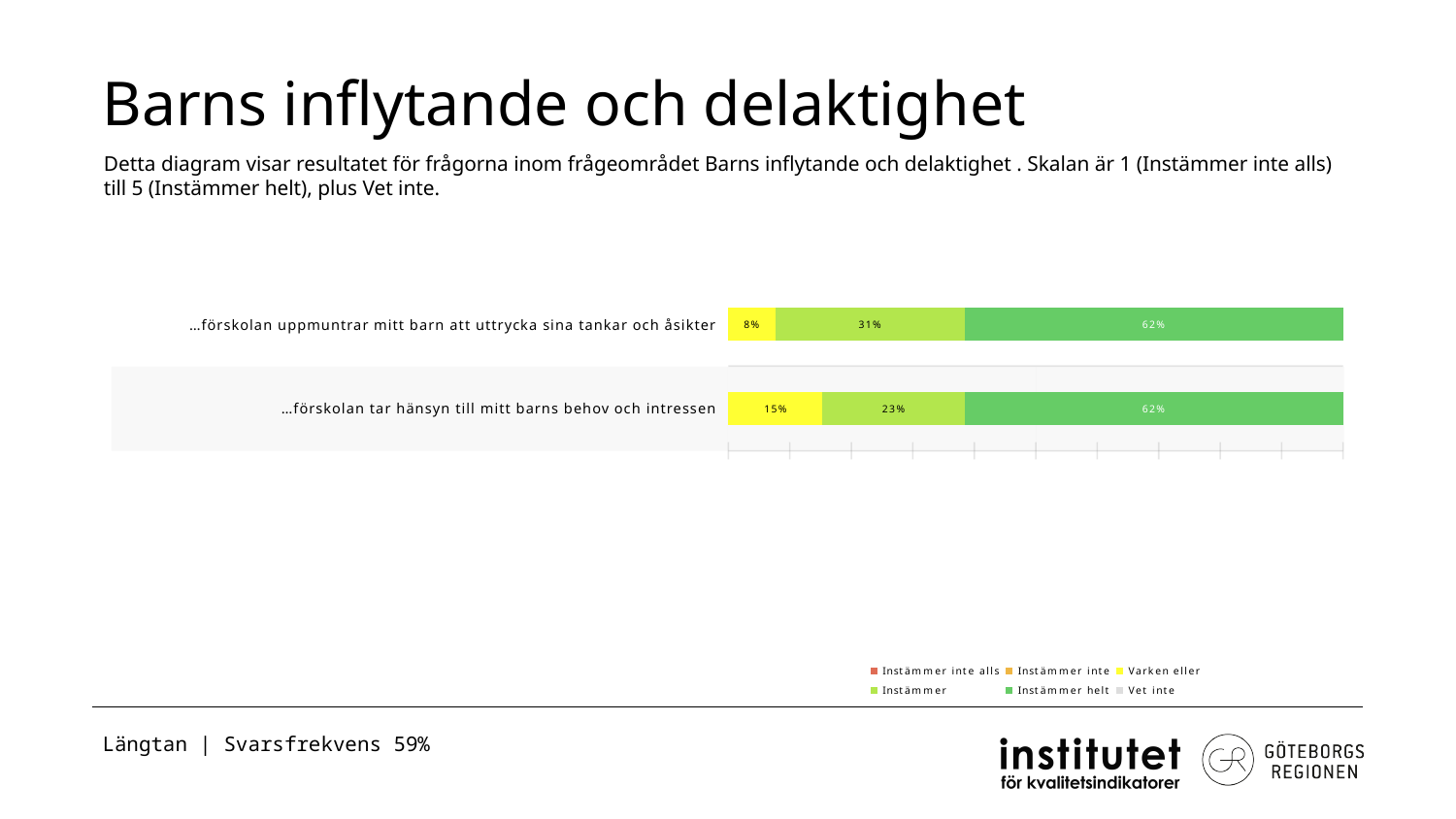
Which statement has the larger 'Varken eller' share? …förskolan tar hänsyn till mitt barns behov och intressen How many series does the legend list? 6 What kind of chart is shown on the slide? Stacked bar chart What is the total of the labelled segments in the bar for '…förskolan uppmuntrar mitt barn att uttrycka sina tankar och åsikter'? 101% How many categories (statements) are plotted in the chart? 2 What is the 'Varken eller' value for '…förskolan tar hänsyn till mitt barns behov och intressen'? 15% What is the difference between the 'Instämmer' values of the two statements? 8% Which legend entry is shown in yellow? Varken eller What is the 'Instämmer' value for '…förskolan uppmuntrar mitt barn att uttrycka sina tankar och åsikter'? 31% What is the 'Instämmer' value for '…förskolan tar hänsyn till mitt barns behov och intressen'? 23% What is the 'Instämmer helt' value for '…förskolan uppmuntrar mitt barn att uttrycka sina tankar och åsikter'? 62% Which segment is the largest in the bar for '…förskolan tar hänsyn till mitt barns behov och intressen'? Instämmer helt